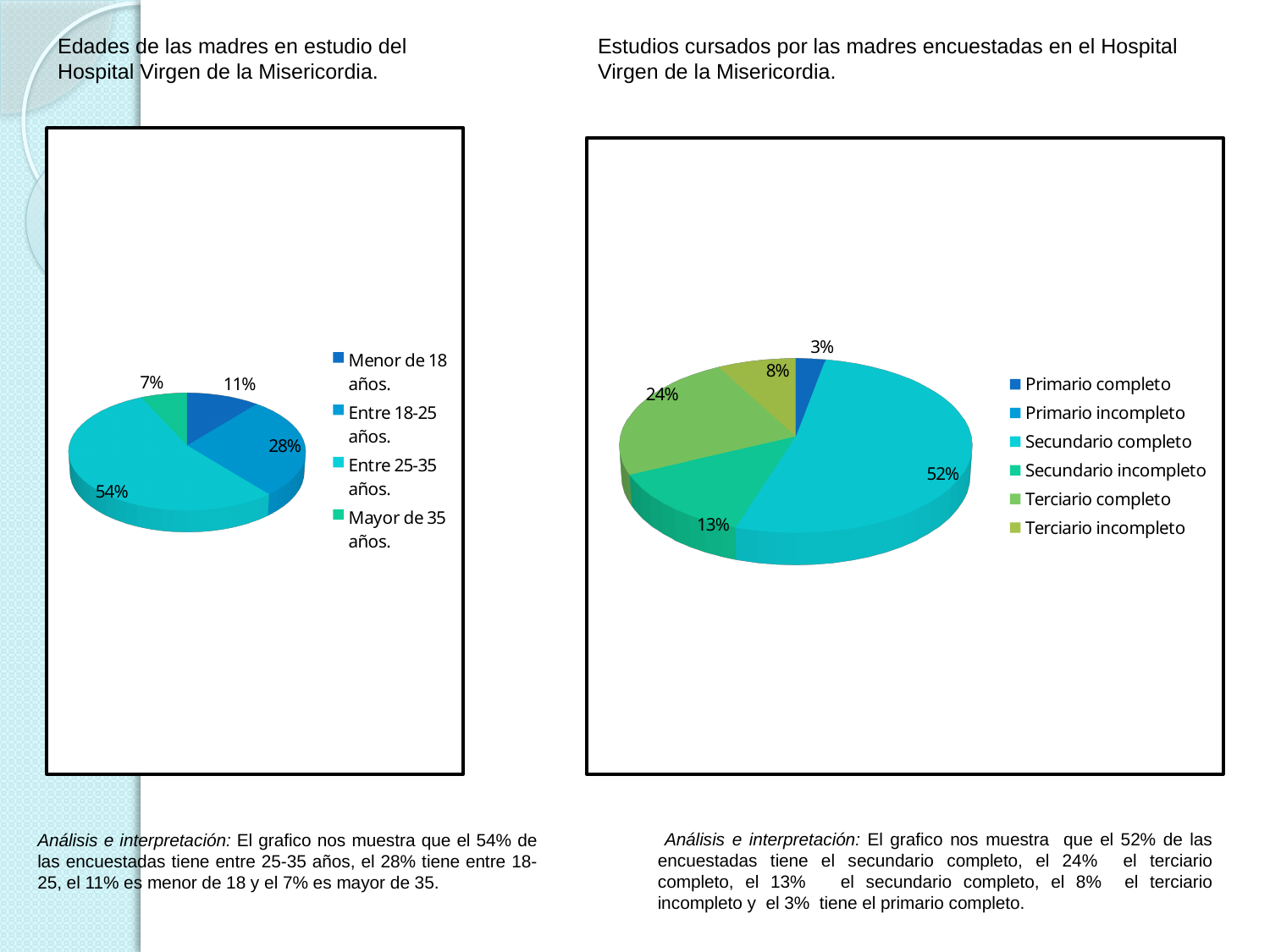
In the chart 'Estudios cursados por las madres encuestadas en el Hospital Virgen de la Misericordia', what percentage of mothers have 'Secundario completo'? 52% In the chart 'Estudios cursados por las madres encuestadas en el Hospital Virgen de la Misericordia', how many categories does the legend list? 6 In the chart 'Edades de las madres en estudio del Hospital Virgen de la Misericordia', what is the difference in percentage points between 'Entre 25-35 años' and 'Entre 18-25 años'? 26 In the chart 'Estudios cursados por las madres encuestadas en el Hospital Virgen de la Misericordia', which is larger: 'Secundario incompleto' or 'Terciario incompleto'? Secundario incompleto In the chart 'Edades de las madres en estudio del Hospital Virgen de la Misericordia', how many legend entries are listed? 4 In the chart 'Estudios cursados por las madres encuestadas en el Hospital Virgen de la Misericordia', what percentage of mothers have 'Terciario completo'? 24% In the chart 'Estudios cursados por las madres encuestadas en el Hospital Virgen de la Misericordia', which category has the largest share? Secundario completo What type of chart is used in 'Estudios cursados por las madres encuestadas en el Hospital Virgen de la Misericordia'? Pie chart In the chart 'Estudios cursados por las madres encuestadas en el Hospital Virgen de la Misericordia', what percentage of mothers have 'Primario completo'? 3% In the chart 'Edades de las madres en estudio del Hospital Virgen de la Misericordia', what percentage of mothers are 'Menor de 18 años'? 11% In the chart 'Edades de las madres en estudio del Hospital Virgen de la Misericordia', which age group has the smallest share? Mayor de 35 años In the chart 'Edades de las madres en estudio del Hospital Virgen de la Misericordia', what percentage of mothers are 'Entre 25-35 años'? 54%